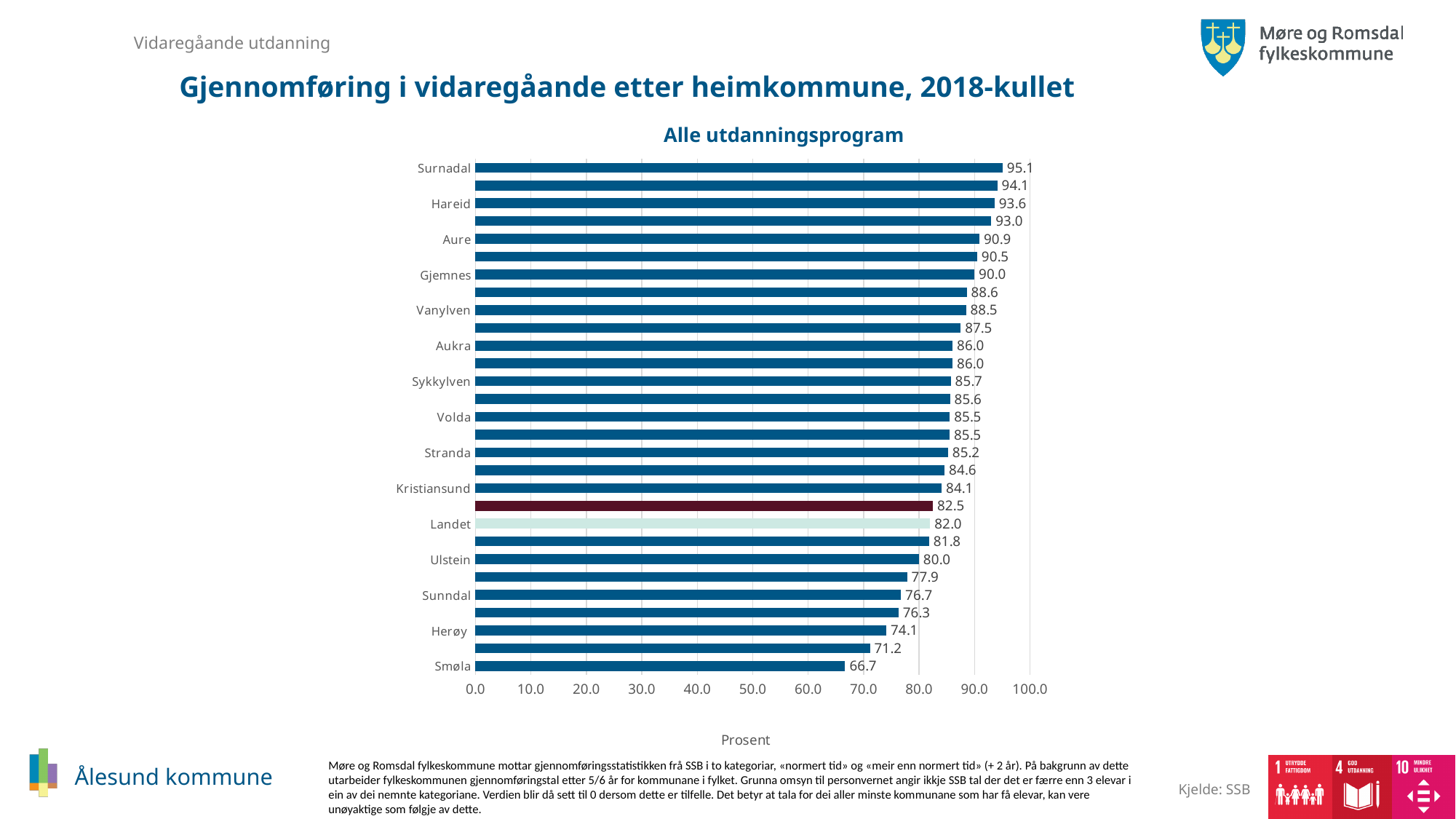
Which is larger, the value for Hareid or the value for Ulstein? Hareid What is the value for Smøla? 66.7 What is the difference between the values for Surnadal and Smøla? 28.4 What is the value for Kristiansund? 84.1 Which category has the highest value? Surnadal What kind of chart is shown on the slide? bar chart Is the value for Herøy greater or less than 80.0? less What is the value for Landet? 82.0 What is the value for Surnadal? 95.1 How many bars are plotted in the chart? 29 What is the title of the chart? Alle utdanningsprogram Which category has the lowest value? Smøla